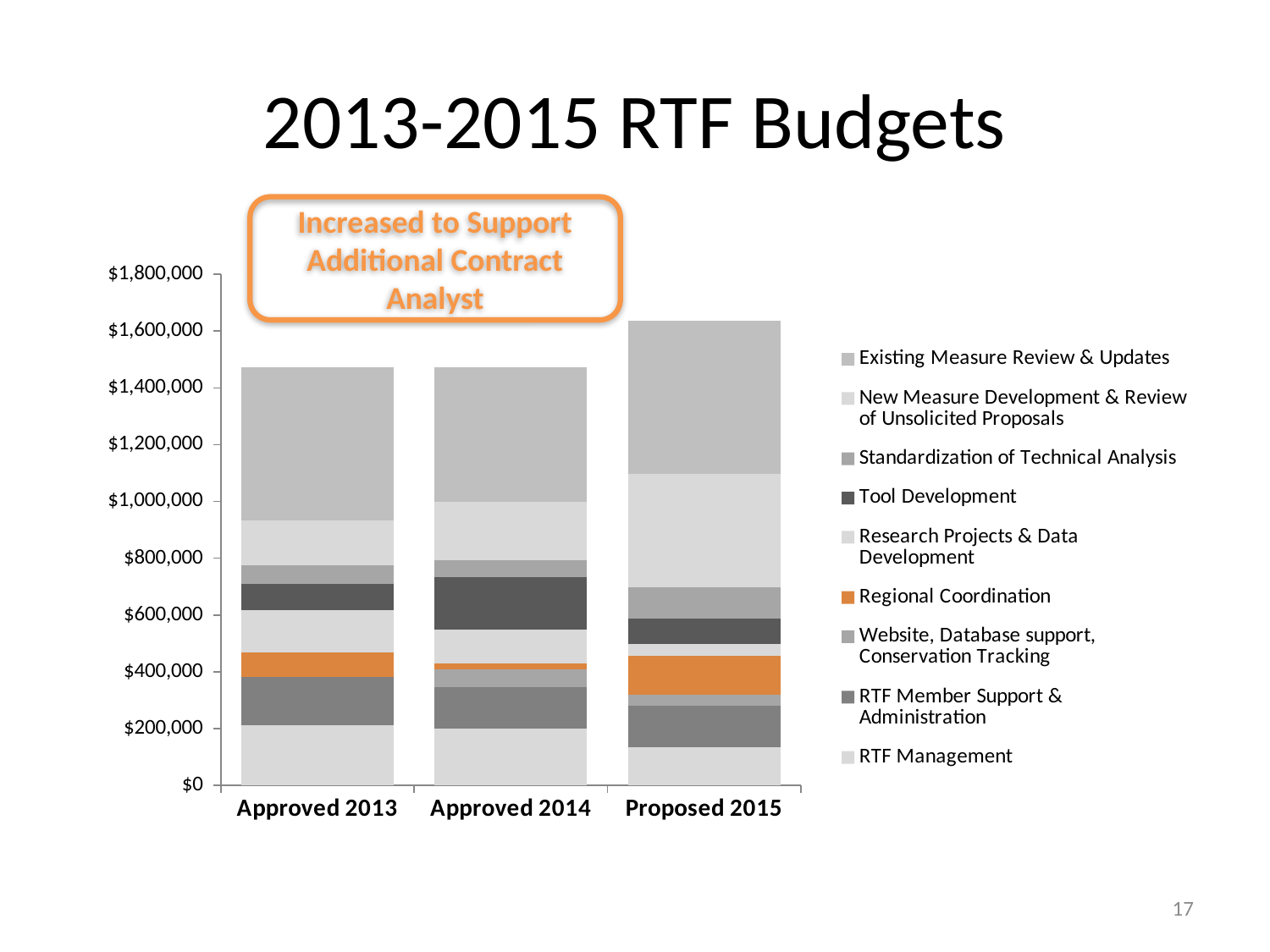
Which budget year has the highest total stacked bar? Proposed 2015 Is the total for Approved 2013 greater or less than $1,600,000? less How many budget years (categories) are shown on the x axis? 3 How many series does the legend list? 9 What is the title of the slide? 2013-2015 RTF Budgets Is the total for Proposed 2015 greater or less than $1,400,000? greater Which is larger, the total for Approved 2013 or the total for Proposed 2015? Proposed 2015 What kind of chart is shown on the slide? Stacked bar chart Which is larger, the Regional Coordination segment in Approved 2014 or in Proposed 2015? Proposed 2015 Does the total budget rise or fall from Approved 2014 to Proposed 2015? rise Which legend series is shown in orange? Regional Coordination